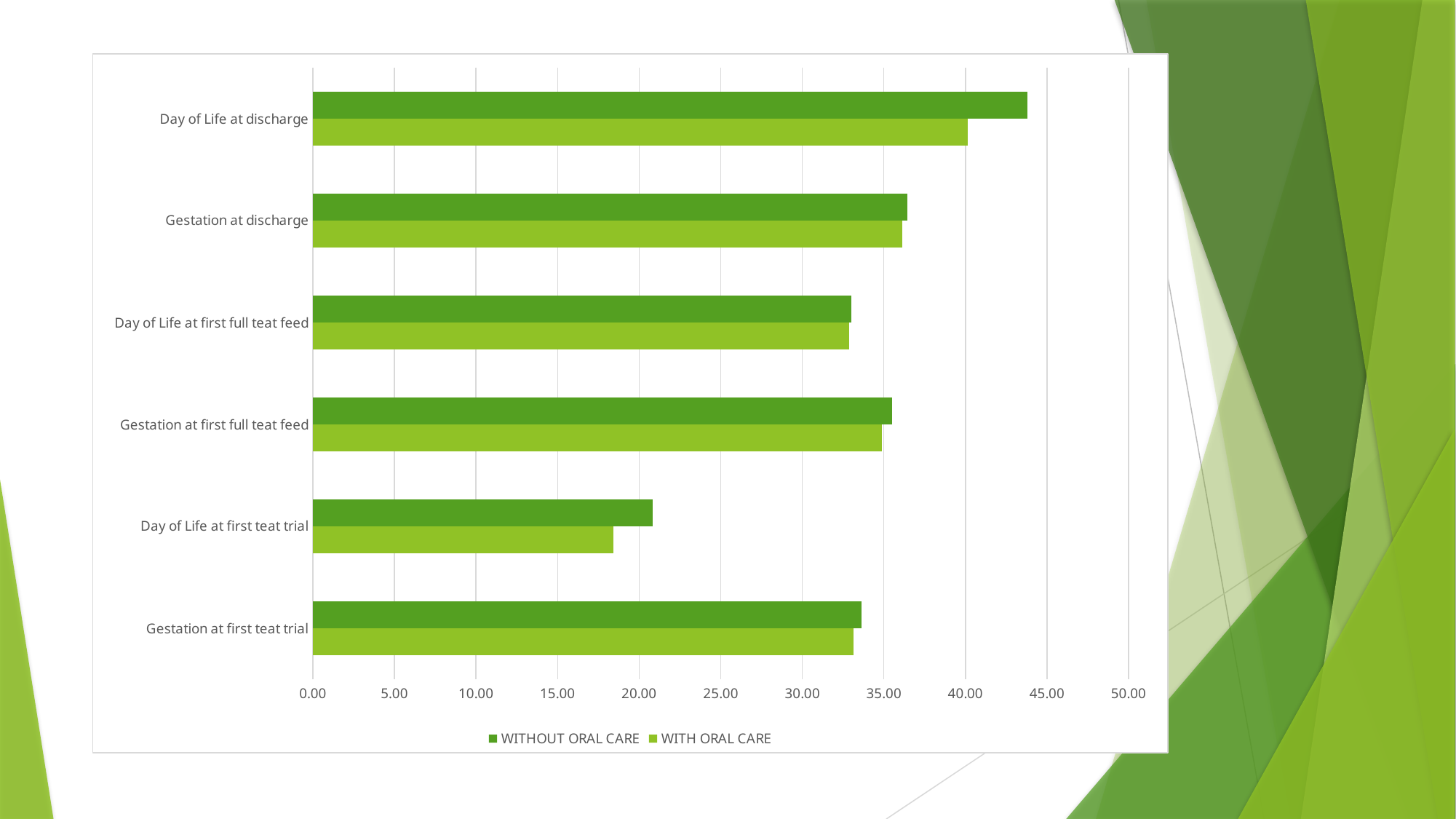
Is the WITH ORAL CARE value for Day of Life at first teat trial greater or less than 20.00? less For Day of Life at discharge, which series has the larger value, WITHOUT ORAL CARE or WITH ORAL CARE? WITHOUT ORAL CARE Which category has the highest value for WITHOUT ORAL CARE? Day of Life at discharge For Day of Life at first teat trial, which series has the larger value, WITHOUT ORAL CARE or WITH ORAL CARE? WITHOUT ORAL CARE What are the two series named in the legend? WITHOUT ORAL CARE and WITH ORAL CARE Is the WITH ORAL CARE value for Gestation at first teat trial greater or less than 30.00? greater Which category has the lowest value for WITH ORAL CARE? Day of Life at first teat trial Is the WITHOUT ORAL CARE value for Day of Life at discharge greater or less than 40.00? greater What kind of chart is shown on the slide? bar chart How many series does the legend list? 2 How many categories are plotted on the chart? 6